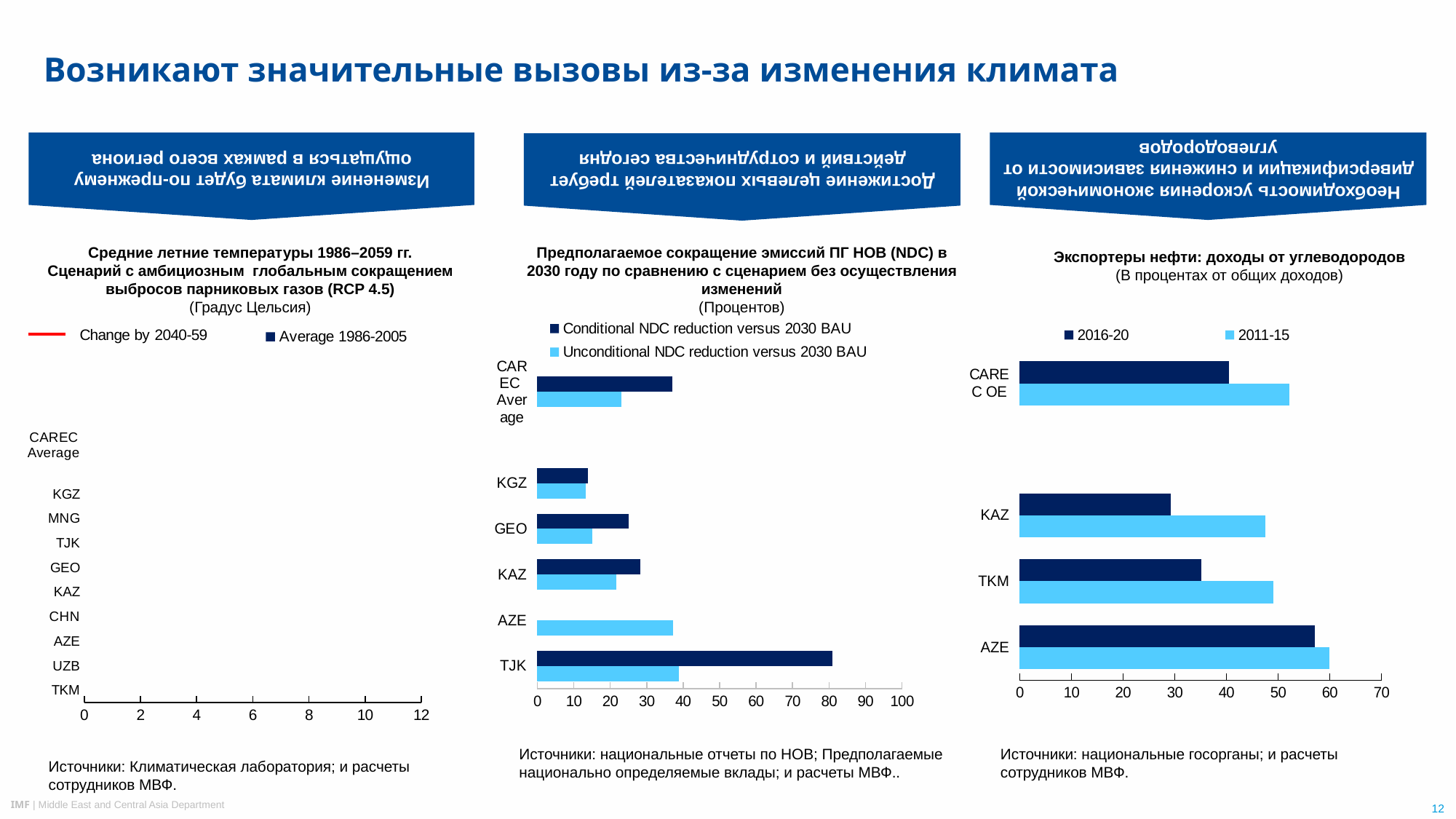
In the middle chart (NDC reduction), is the Conditional NDC reduction value for KGZ greater or less than 20? less In the middle chart (NDC reduction), how many series does the legend list? 2 In the right chart 'Экспортеры нефти: доходы от углеводородов', for KAZ, which is larger: the 2016-20 value or the 2011-15 value? 2011-15 In the middle chart (NDC reduction), is the Conditional NDC reduction value for TJK greater or less than 70? greater In the right chart 'Экспортеры нефти: доходы от углеводородов', which category has the lowest 2016-20 value? KAZ In the right chart 'Экспортеры нефти: доходы от углеводородов', how many categories are shown on the vertical axis? 4 What kind of chart is the middle chart, 'Предполагаемое сокращение эмиссий ПГ НОВ (NDC)'? Bar chart In the right chart 'Экспортеры нефти: доходы от углеводородов', which category has the highest 2016-20 value? AZE In the middle chart (NDC reduction), how many categories are shown on the vertical axis? 6 In the right chart 'Экспортеры нефти: доходы от углеводородов', is the 2011-15 value for AZE greater or less than 50? greater In the right chart 'Экспортеры нефти: доходы от углеводородов', how many series does the legend list? 2 In the middle chart (NDC reduction), which category has the highest Conditional NDC reduction versus 2030 BAU? TJK